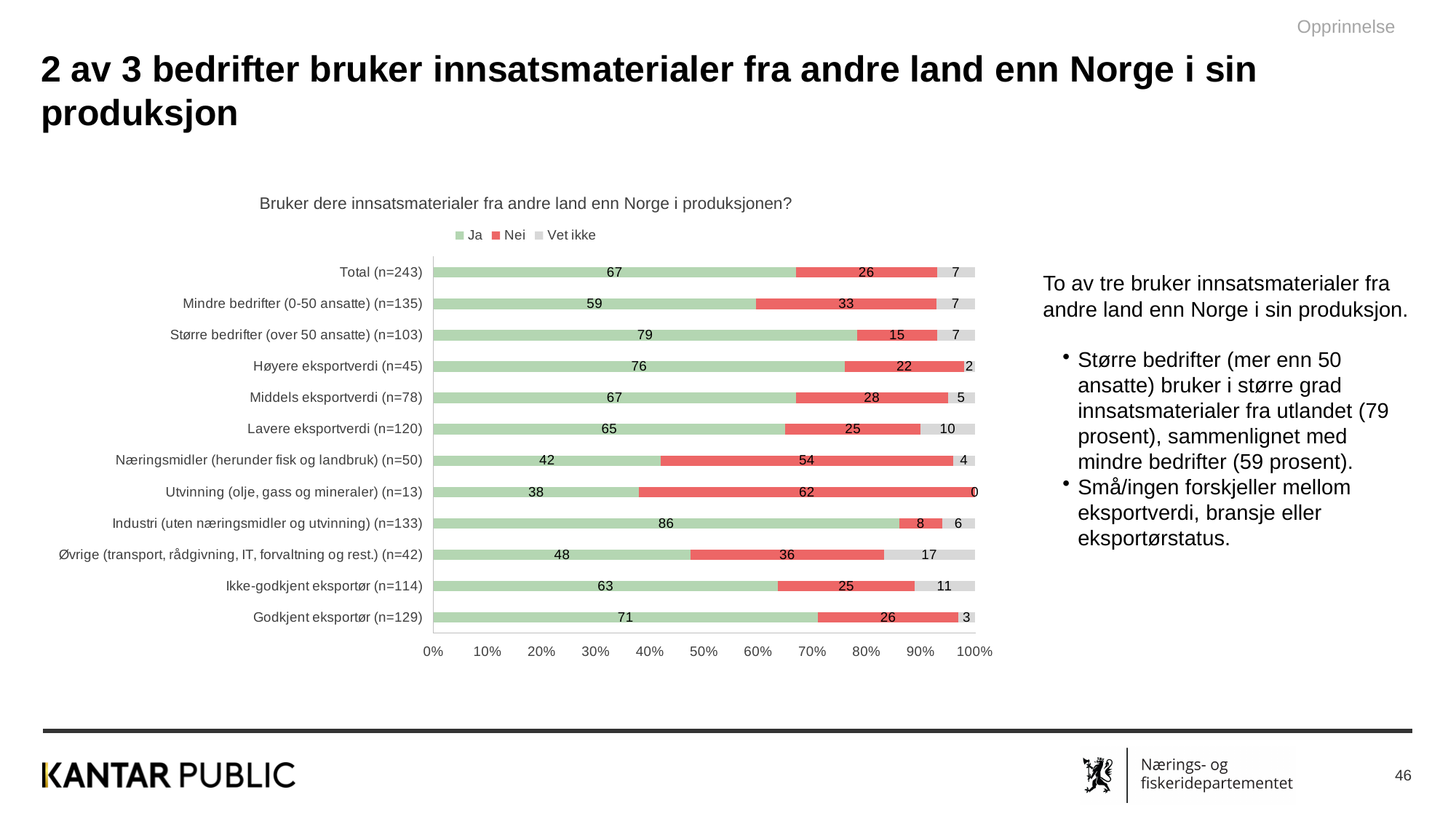
How many categories are shown on the chart? 12 What is the total of the stacked bar for Total (n=243)? 100 Which category has the lowest 'Ja' value? Utvinning (olje, gass og mineraler) (n=13) What is the 'Vet ikke' value for Øvrige (transport, rådgivning, IT, forvaltning og rest.) (n=42)? 17 What kind of chart is shown on the slide? Stacked bar chart How many series does the legend list? 3 Which category has the highest 'Ja' value? Industri (uten næringsmidler og utvinning) (n=133) What is the title of the chart? Bruker dere innsatsmaterialer fra andre land enn Norge i produksjonen? What is the difference between the 'Ja' values for Større bedrifter (over 50 ansatte) (n=103) and Mindre bedrifter (0-50 ansatte) (n=135)? 20 What is the 'Ja' value for Total (n=243)? 67 What is the 'Nei' value for Næringsmidler (herunder fisk og landbruk) (n=50)? 54 Which has a larger 'Nei' value: Mindre bedrifter (0-50 ansatte) (n=135) or Større bedrifter (over 50 ansatte) (n=103)? Mindre bedrifter (0-50 ansatte) (n=135)